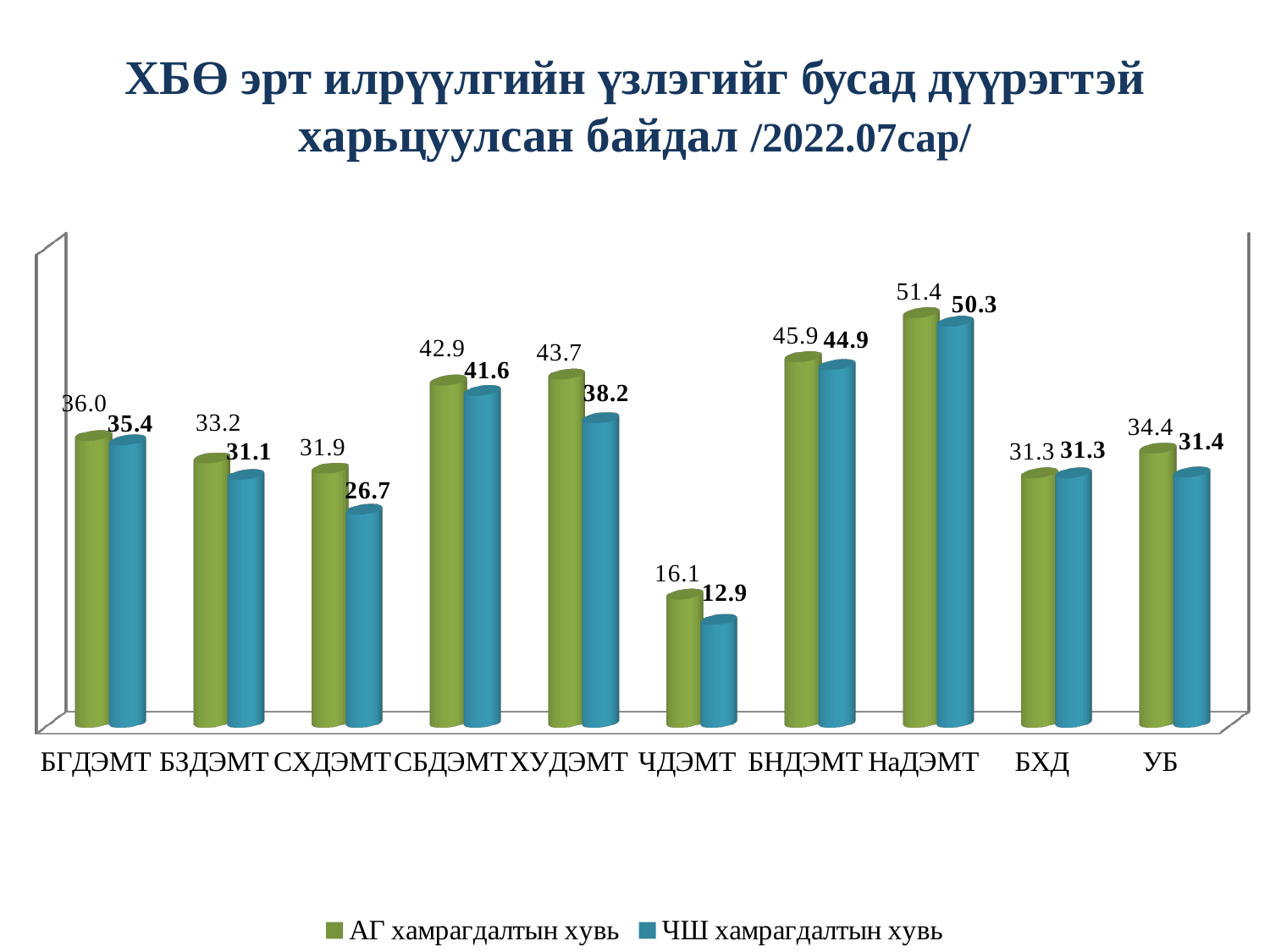
Which is larger: the ЧШ хамрагдалтын хувь value for СБДЭМТ or for БНДЭМТ? БНДЭМТ What is the value of ЧШ хамрагдалтын хувь for ХУДЭМТ? 38.2 What is the value of АГ хамрагдалтын хувь for БГДЭМТ? 36.0 What is the value of ЧШ хамрагдалтын хувь for СХДЭМТ? 26.7 What is the difference between the АГ хамрагдалтын хувь values for НаДЭМТ and ЧДЭМТ? 35.3 Which category has the lowest value for ЧШ хамрагдалтын хувь? ЧДЭМТ Which category has the highest value for АГ хамрагдалтын хувь? НаДЭМТ How many categories are shown on the x axis? 10 What kind of chart is shown on the slide? Bar chart How many series does the legend list? 2 What is the value of АГ хамрагдалтын хувь for УБ? 34.4 What is the difference between the АГ хамрагдалтын хувь and ЧШ хамрагдалтын хувь values for ХУДЭМТ? 5.5